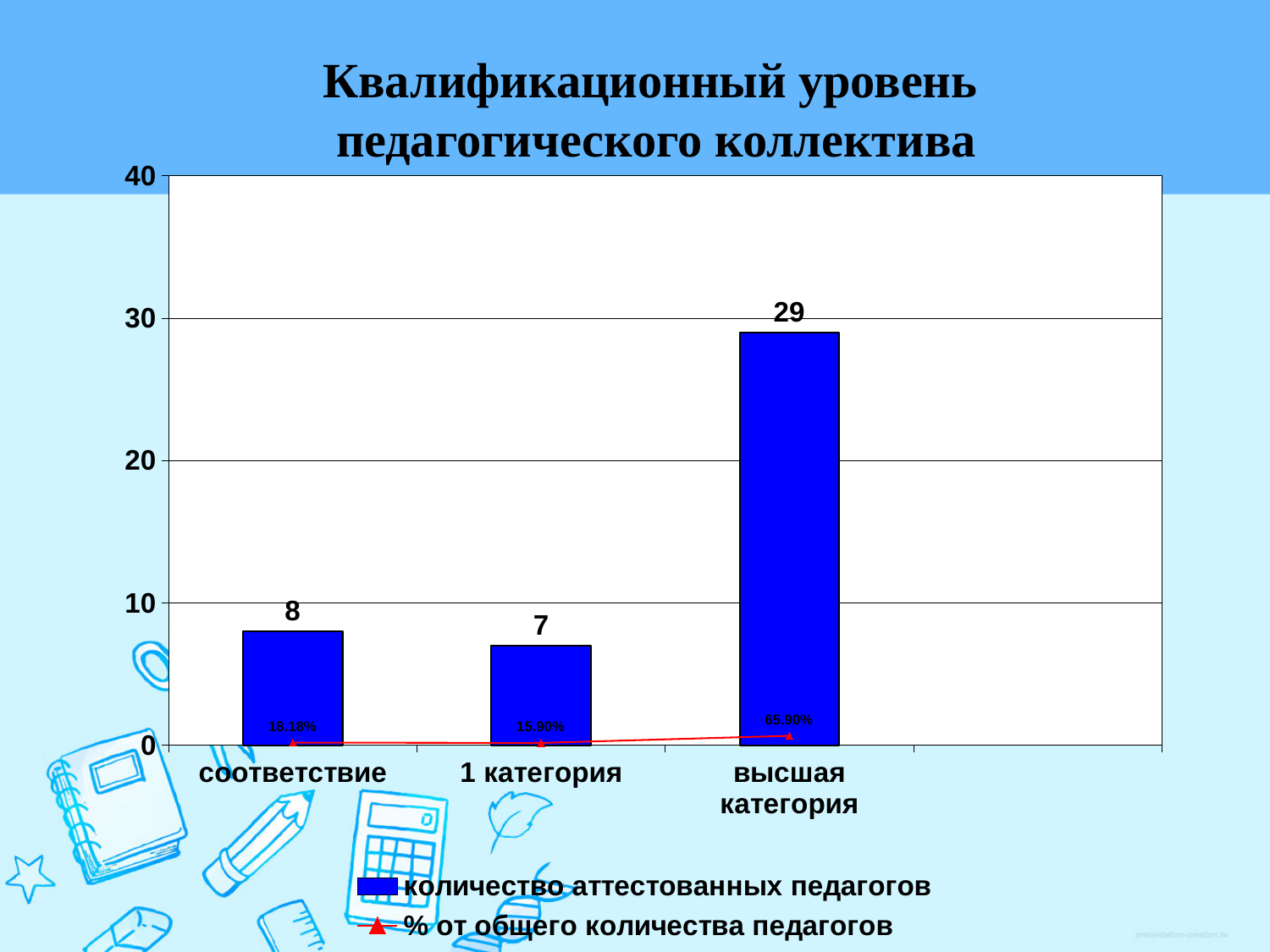
What is the title of the chart? Квалификационный уровень педагогического коллектива How many categories are shown on the x axis? 3 Which category has the lowest number of certified teachers? 1 категория What percentage of the total number of teachers (% от общего количества педагогов) is shown for 'высшая категория'? 65.90% What is the number of certified teachers (количество аттестованных педагогов) for the category 'высшая категория'? 29 How many series does the legend list? 2 Which category has the highest number of certified teachers? высшая категория What percentage of the total number of teachers is shown for 'соответствие'? 18.18% What is the number of certified teachers for the category 'соответствие'? 8 What is the difference in the number of certified teachers between 'высшая категория' and 'соответствие'? 21 Which has more certified teachers: 'соответствие' or '1 категория'? соответствие What is the number of certified teachers for '1 категория'? 7